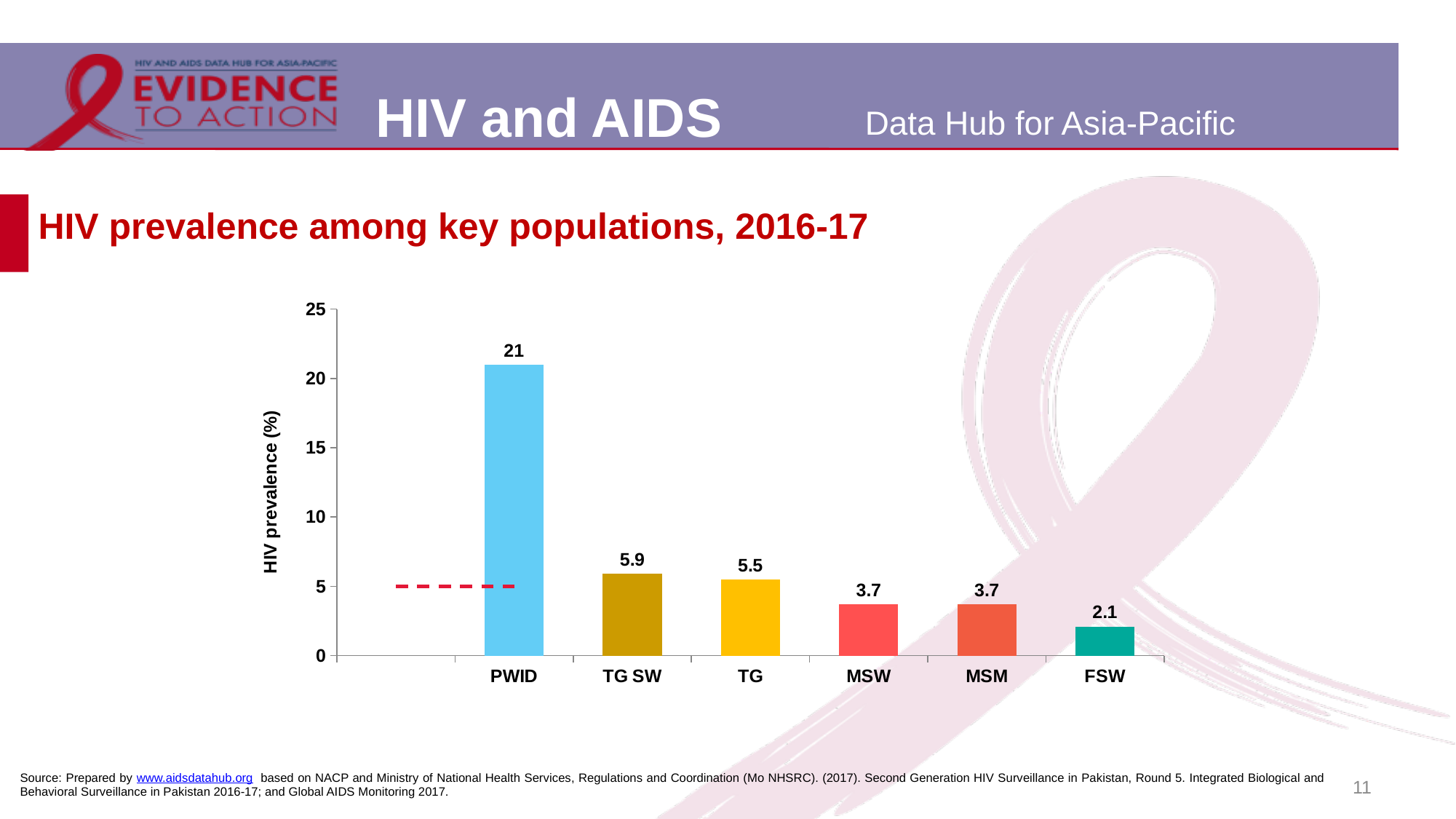
What is the label of the vertical axis? HIV prevalence (%) What is the difference in HIV prevalence between TG and FSW? 3.4 Which key population has the highest HIV prevalence? PWID Which key population has the lowest HIV prevalence? FSW What is the HIV prevalence among FSW? 2.1 What is the HIV prevalence among TG SW? 5.9 What kind of chart is shown on the slide? bar chart How many key populations are shown on the chart? 6 Is the HIV prevalence for PWID greater or less than 20? greater Which has a higher HIV prevalence, TG SW or TG? TG SW What is the HIV prevalence among PWID? 21 What is the difference in HIV prevalence between PWID and TG SW? 15.1